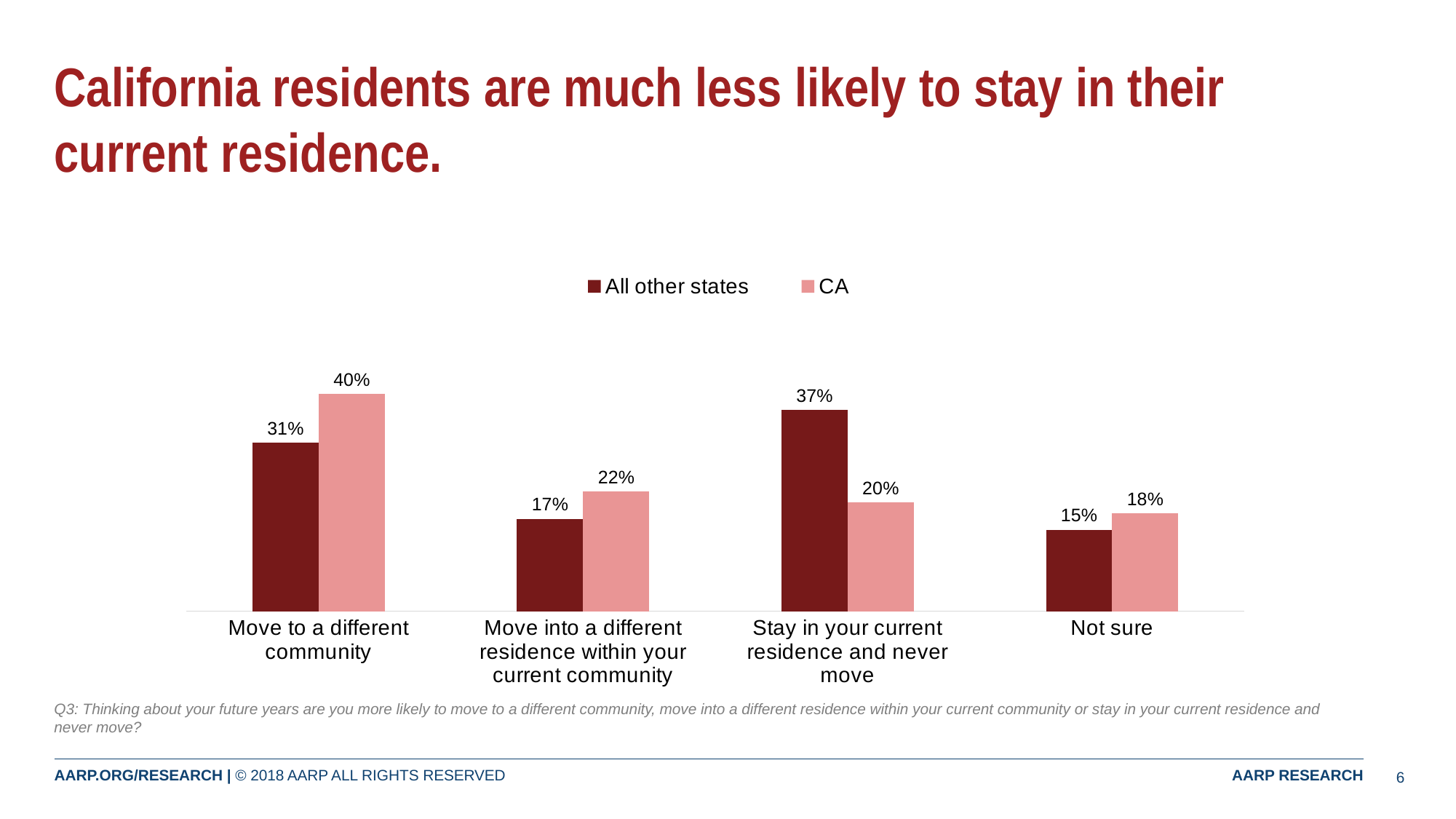
Which is larger for 'Move to a different community': all other states or CA? CA Which category has the lowest value for all other states? Not sure How many categories are shown on the x axis? 4 What is the value for CA in the 'Not sure' category? 18% How many series does the legend list? 2 What percentage of CA respondents said they would move to a different community? 40% What is the value for all other states in the 'Move into a different residence within your current community' category? 17% What percentage of respondents from all other states said they would stay in their current residence and never move? 37% What are the two series named in the legend? All other states and CA What is the difference between all other states and CA for 'Stay in your current residence and never move'? 17% Which category has the highest value for CA? Move to a different community What kind of chart is shown on the slide? Bar chart